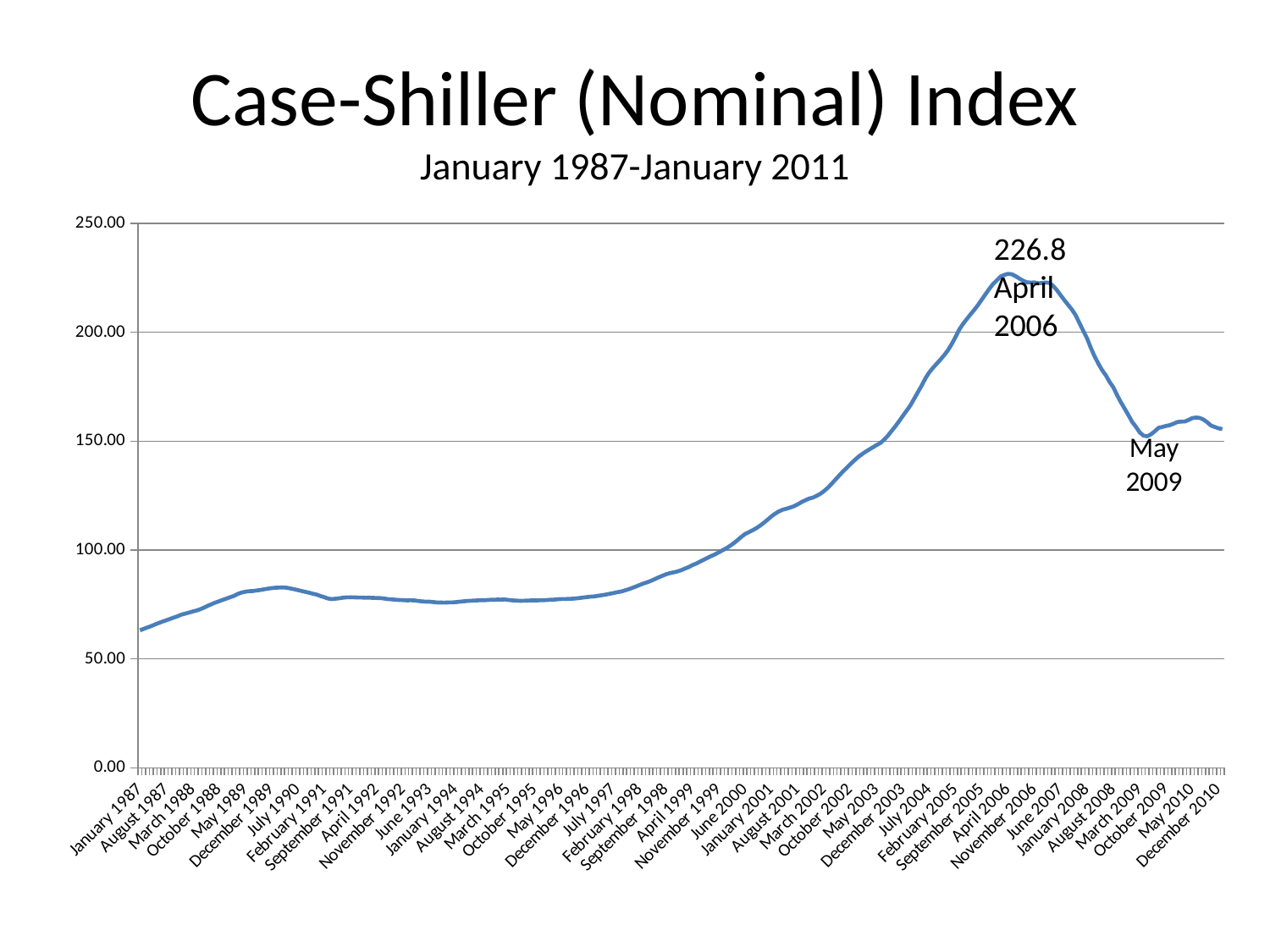
Which month is annotated as the low point after the 2006 peak? May 2009 Is the index value for January 1987 greater or less than 100? less In which month does the Case-Shiller (Nominal) Index reach its highest value? April 2006 What kind of chart is shown on the slide? line chart Which has the larger index value, April 2006 or May 2009? April 2006 Does the index rise or fall between April 2006 and May 2009? fall Which has the larger index value, January 1987 or December 2010? December 2010 What is the peak value of the Case-Shiller (Nominal) Index labelled on the chart? 226.8 Is the index value for February 2005 greater or less than 150? greater Is the index value for December 2010 greater or less than 200? less What period does the chart cover according to the subtitle? January 1987-January 2011